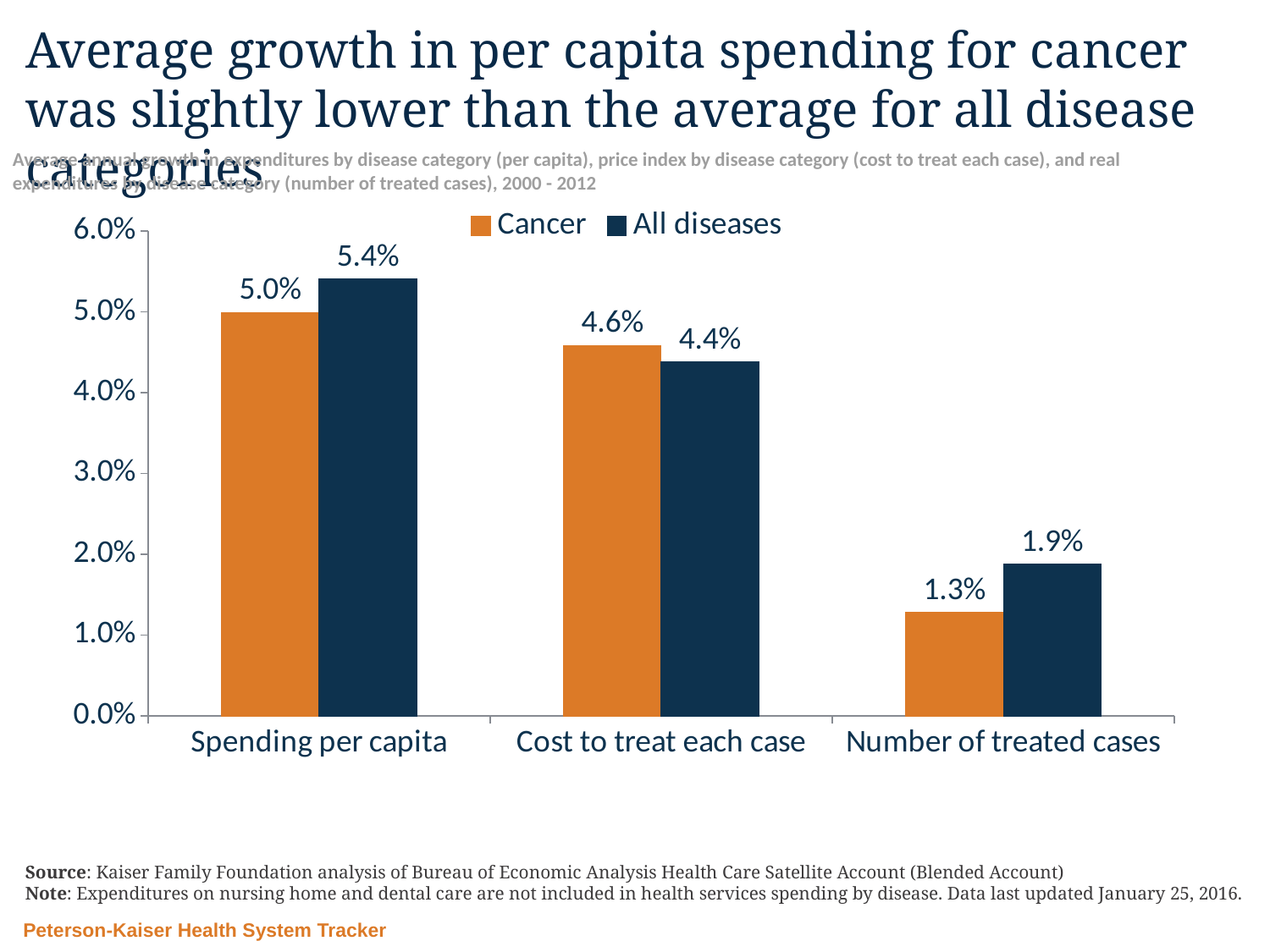
Is the value for All diseases in the Number of treated cases category greater or less than 2.0%? less Which category has the highest value for All diseases? Spending per capita Which category has the lowest value for Cancer? Number of treated cases How many categories are shown on the x axis? 3 What is the difference between All diseases and Cancer in the Spending per capita category? 0.4% How many series does the legend list? 2 In the Cost to treat each case category, which is larger: Cancer or All diseases? Cancer What is the value for All diseases in the Cost to treat each case category? 4.4% What is the difference between All diseases and Cancer in the Number of treated cases category? 0.6% What kind of chart is shown on the slide? bar chart What is the value for Cancer in the Number of treated cases category? 1.3% What is the value for Cancer in the Spending per capita category? 5.0%